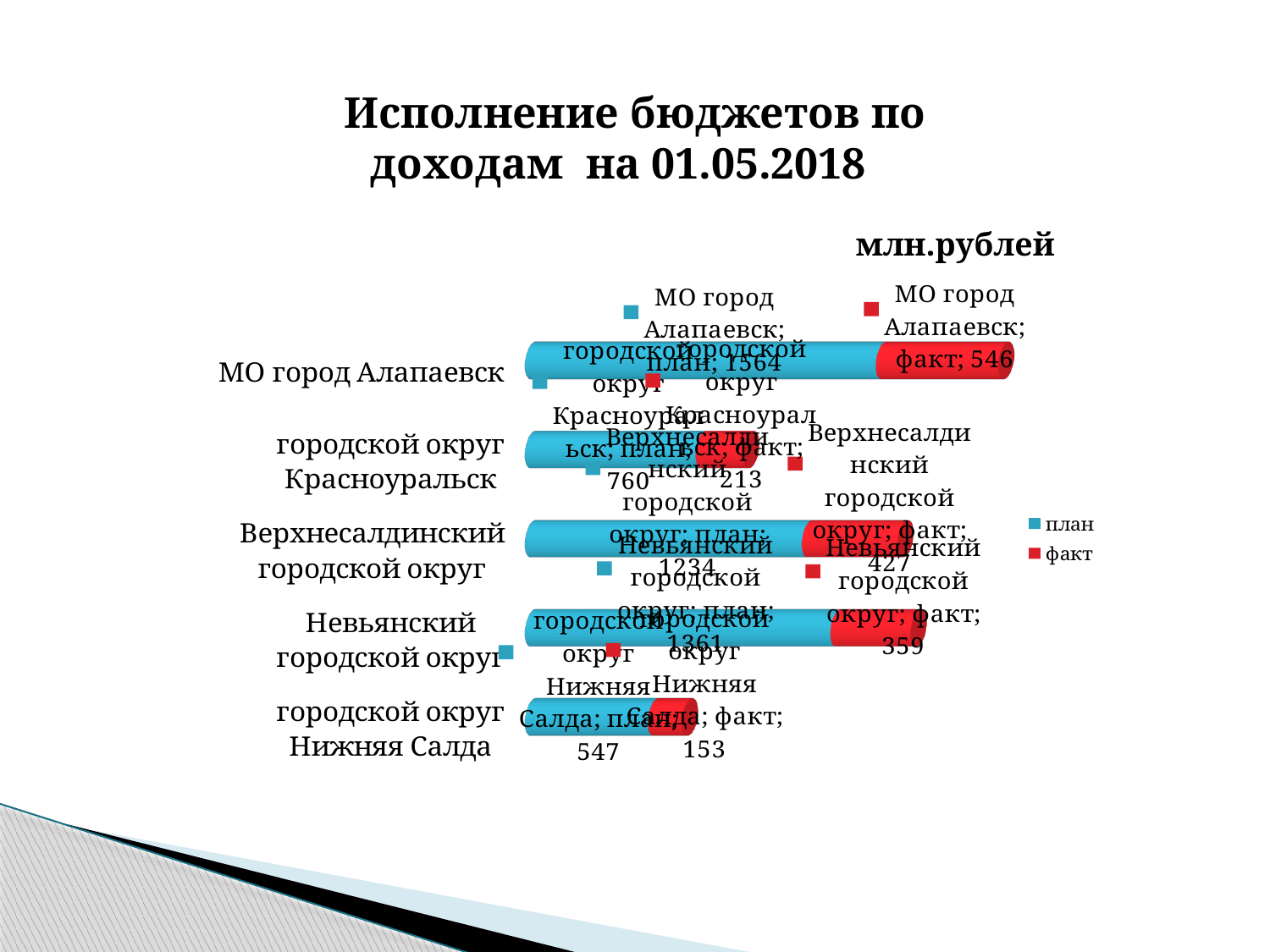
What is the план value for Невьянский городской округ? 1361 Which is larger, the факт value for городской округ Красноуральск or the факт value for Верхнесалдинский городской округ? Верхнесалдинский городской округ What is the факт value for МО город Алапаевск? 546 How many series does the legend list? 2 Which category has the lowest факт value? городской округ Нижняя Салда What is the план value for городской округ Красноуральск? 760 What is the факт value for городской округ Нижняя Салда? 153 What is the difference between the план and факт values for Невьянский городской округ? 1002 What is the план value for МО город Алапаевск? 1564 Which category has the highest план value? МО город Алапаевск What is the факт value for Верхнесалдинский городской округ? 427 What kind of chart is shown on the slide? bar chart